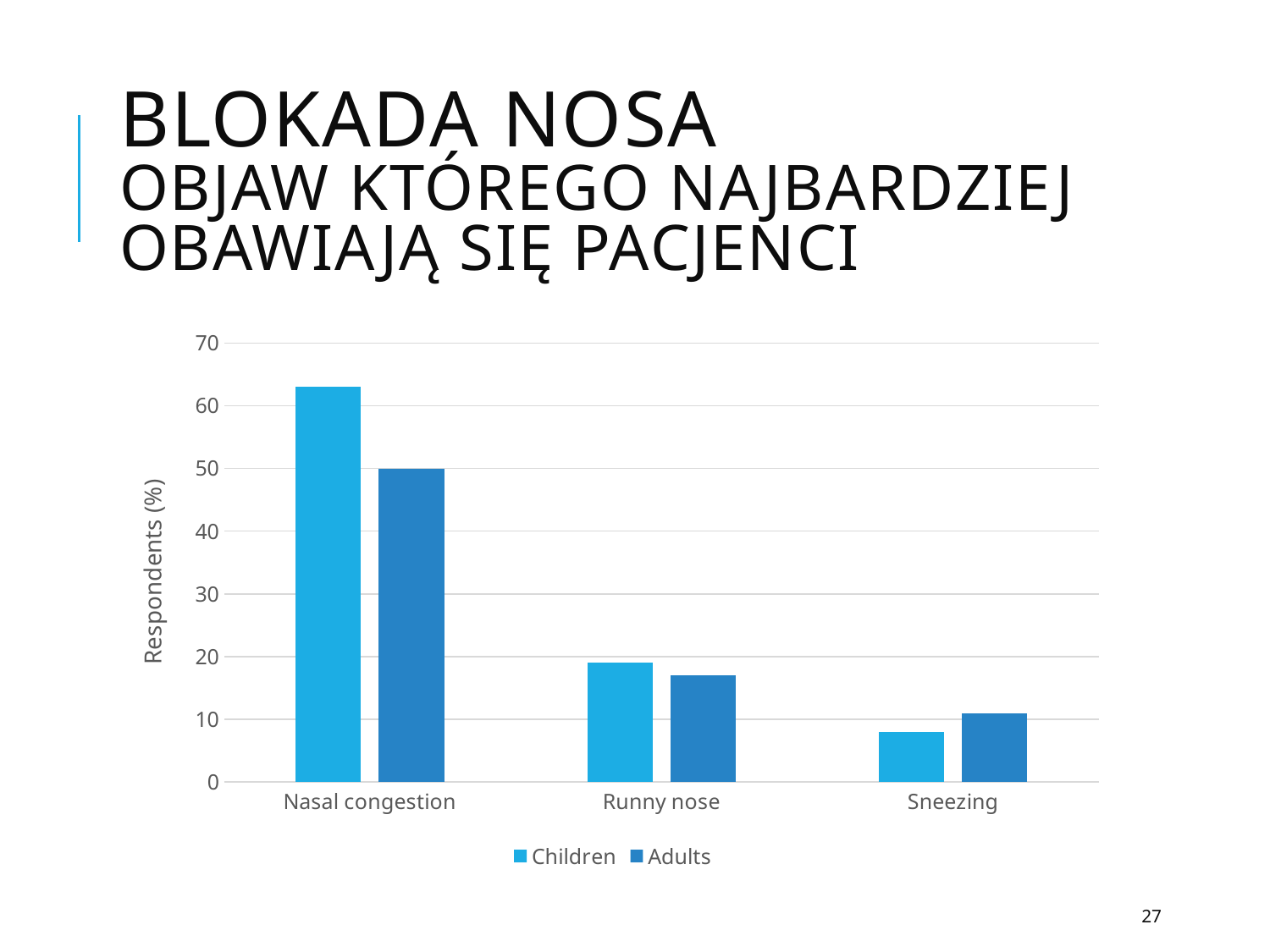
For Nasal congestion, which series has the larger value, Children or Adults? Children What is the label of the vertical axis of the chart? Respondents (%) Which category has the highest value for Children? Nasal congestion What are the two series listed in the chart's legend? Children and Adults How many series does the chart's legend list? 2 How many categories are shown on the x axis of the chart? 3 Is the value for Children in Nasal congestion greater or less than 60? greater Is the value for Adults in Runny nose greater or less than 20? less Which category has the lowest value for Adults? Sneezing Is the value for Children in Sneezing greater or less than 10? less For Sneezing, which series has the larger value, Children or Adults? Adults What kind of chart is shown on the slide? bar chart